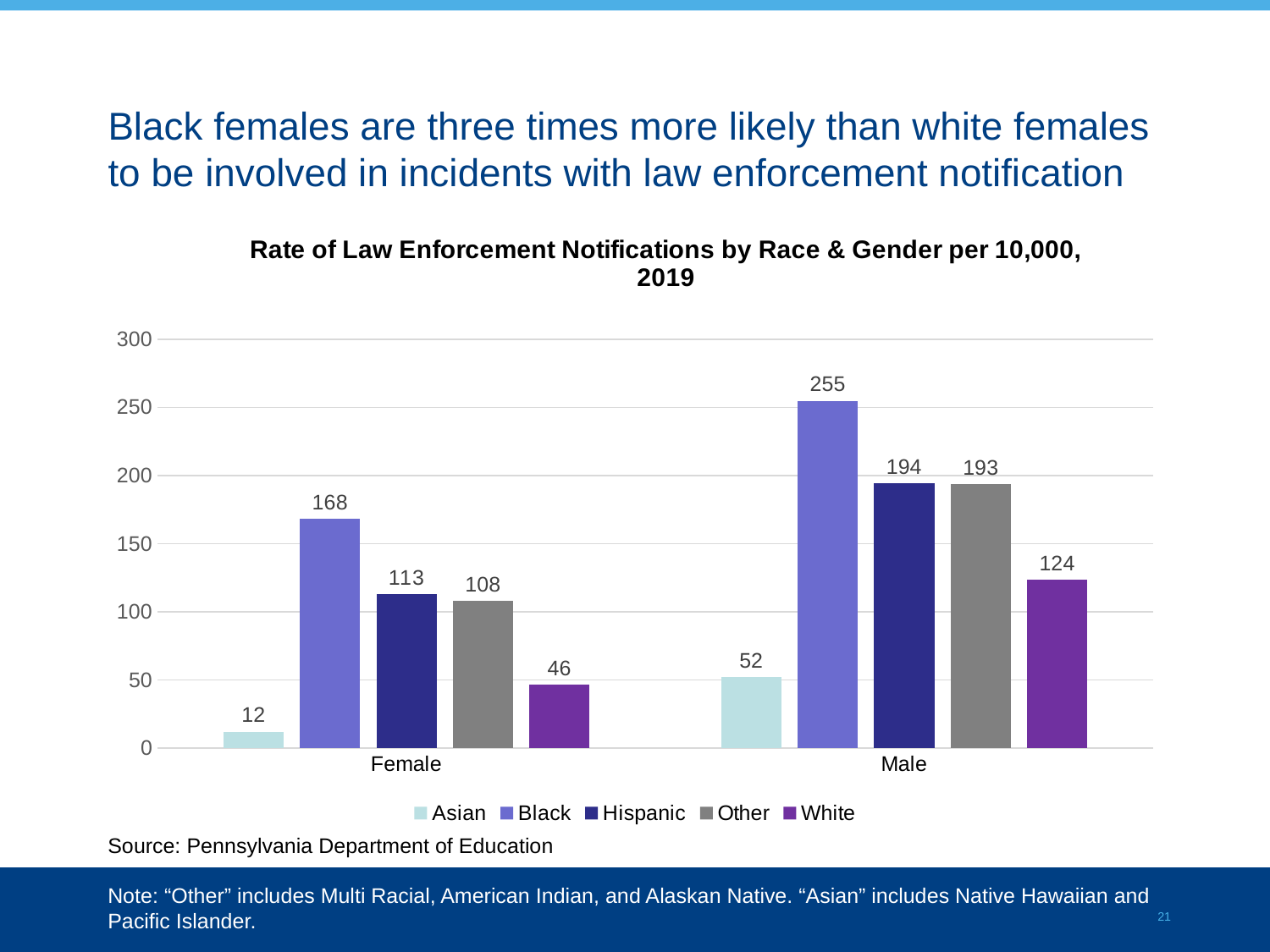
Which race group has the highest rate among males? Black What is the difference between the rates for Black females and White females? 122 What is the rate of law enforcement notifications for White females? 46 What is the rate of law enforcement notifications for Black females? 168 Which race group has the lowest rate among females? Asian How many gender categories are shown on the x axis? 2 Is the rate for White males greater or less than 100? greater How many series does the legend list? 5 What is the difference between the rates for Black males and Black females? 87 What is the rate of law enforcement notifications for Asian males? 52 Which is larger, the rate for Hispanic females or the rate for Other females? Hispanic females What kind of chart is shown on the slide? Bar chart